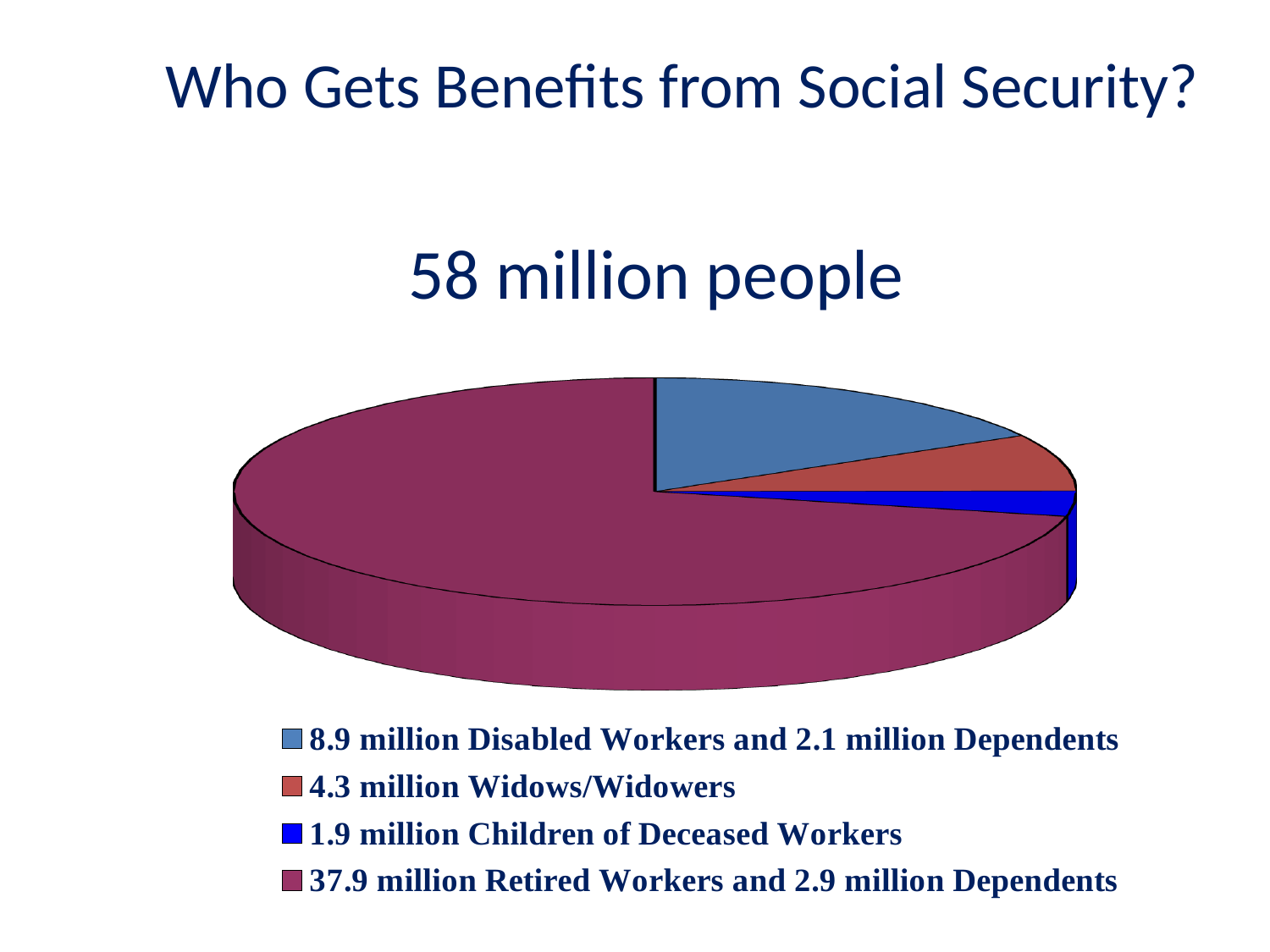
What kind of chart is shown on the slide? pie chart According to the legend, how many widows/widowers receive benefits? 4.3 million According to the legend, how many disabled workers receive benefits? 8.9 million How many entries does the legend list? 4 How many slices does the pie chart have? 4 How many more widows/widowers than children of deceased workers receive benefits, according to the legend? 2.4 million According to the legend, how many children of deceased workers receive benefits? 1.9 million What total number of people does the slide say receive Social Security benefits? 58 million people Which group takes up the smallest slice of the pie? 1.9 million Children of Deceased Workers What is the title of the slide? Who Gets Benefits from Social Security? Which slice is larger: Widows/Widowers or Children of Deceased Workers? Widows/Widowers Which group takes up the largest slice of the pie? 37.9 million Retired Workers and 2.9 million Dependents